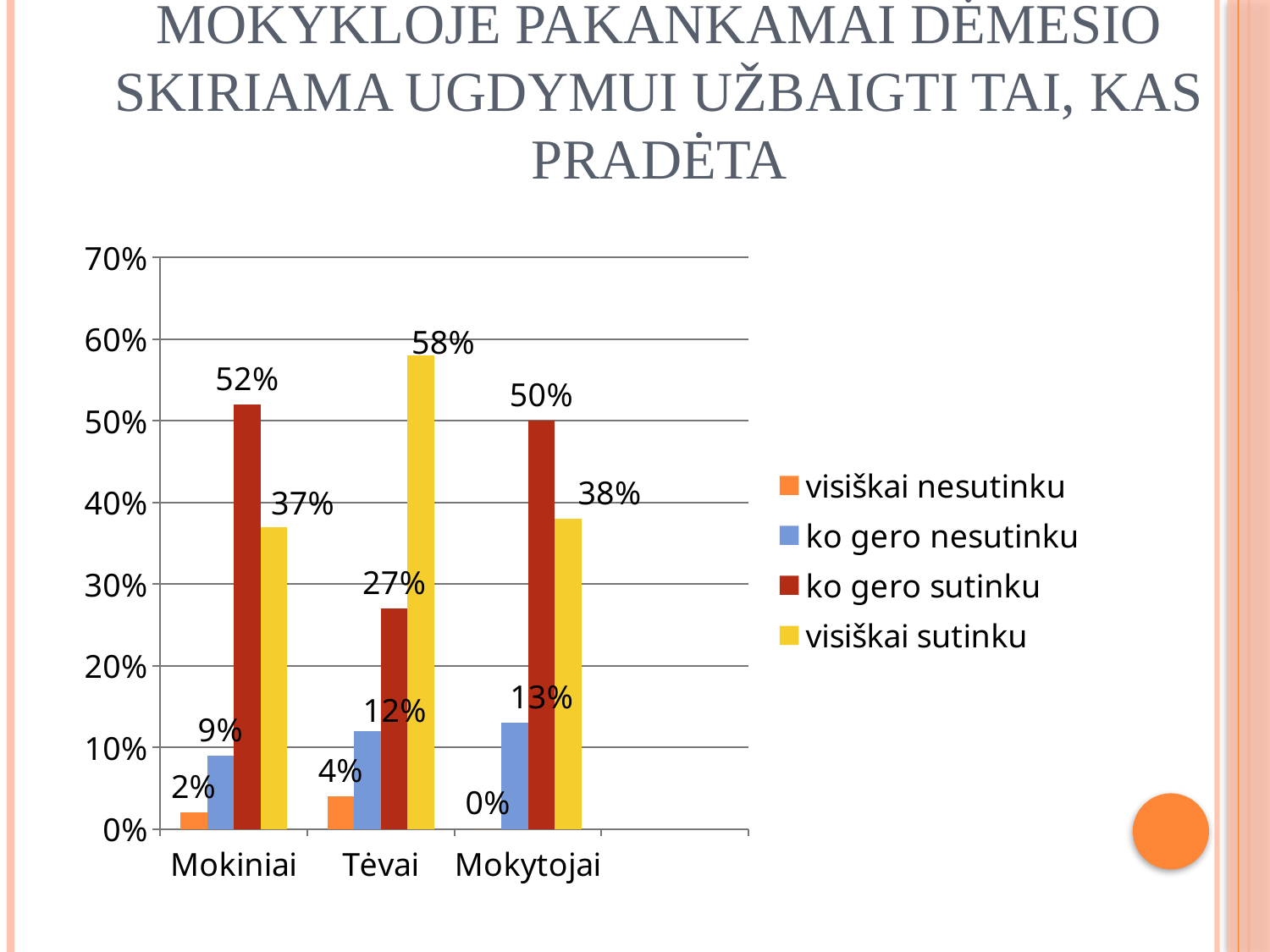
What is the difference between the "ko gero sutinku" value for Mokiniai and the "ko gero sutinku" value for Mokytojai? 2% Which category has the lowest value for "ko gero sutinku"? Tėvai What kind of chart is shown on the slide? Bar chart Which category has the highest value for "visiškai sutinku"? Tėvai How many categories are shown on the x axis? 3 Which is larger: the "visiškai sutinku" value for Mokiniai or the "visiškai sutinku" value for Mokytojai? Mokytojai What is the value for "visiškai sutinku" in the Tėvai category? 58% What is the value for "visiškai nesutinku" in the Mokytojai category? 0% Which colour represents the "visiškai sutinku" series in the legend? Yellow How many series does the legend list? 4 What is the value for "ko gero sutinku" in the Mokiniai category? 52% What is the value for "ko gero nesutinku" in the Tėvai category? 12%